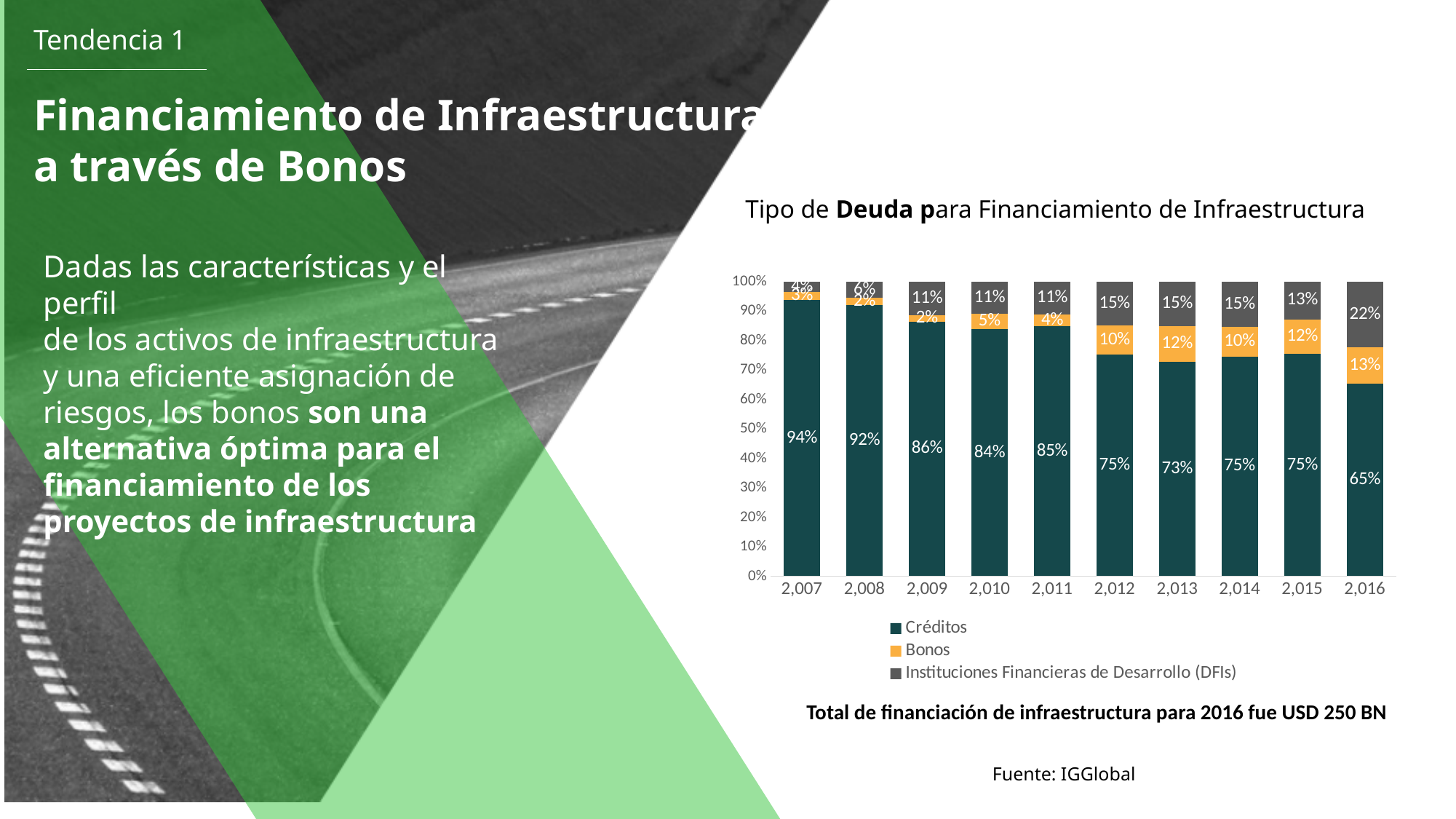
What is the share of Instituciones Financieras de Desarrollo (DFIs) in 2016? 22% In which year is the Créditos share the lowest? 2,016 What is the Bonos share in 2013? 12% What is the Créditos share in 2009? 86% In which year is the Créditos share the highest? 2,007 By how many percentage points did the Créditos share fall from 2009 to 2016? 21 What is the Créditos share in 2016? 65% How many series does the legend list? 3 What type of chart is shown on the slide? Stacked bar chart How many years are shown on the x axis? 10 Which is larger in 2015, the Bonos share or the DFIs share? DFIs share Does the Créditos share generally rise or fall from 2007 to 2016? Fall